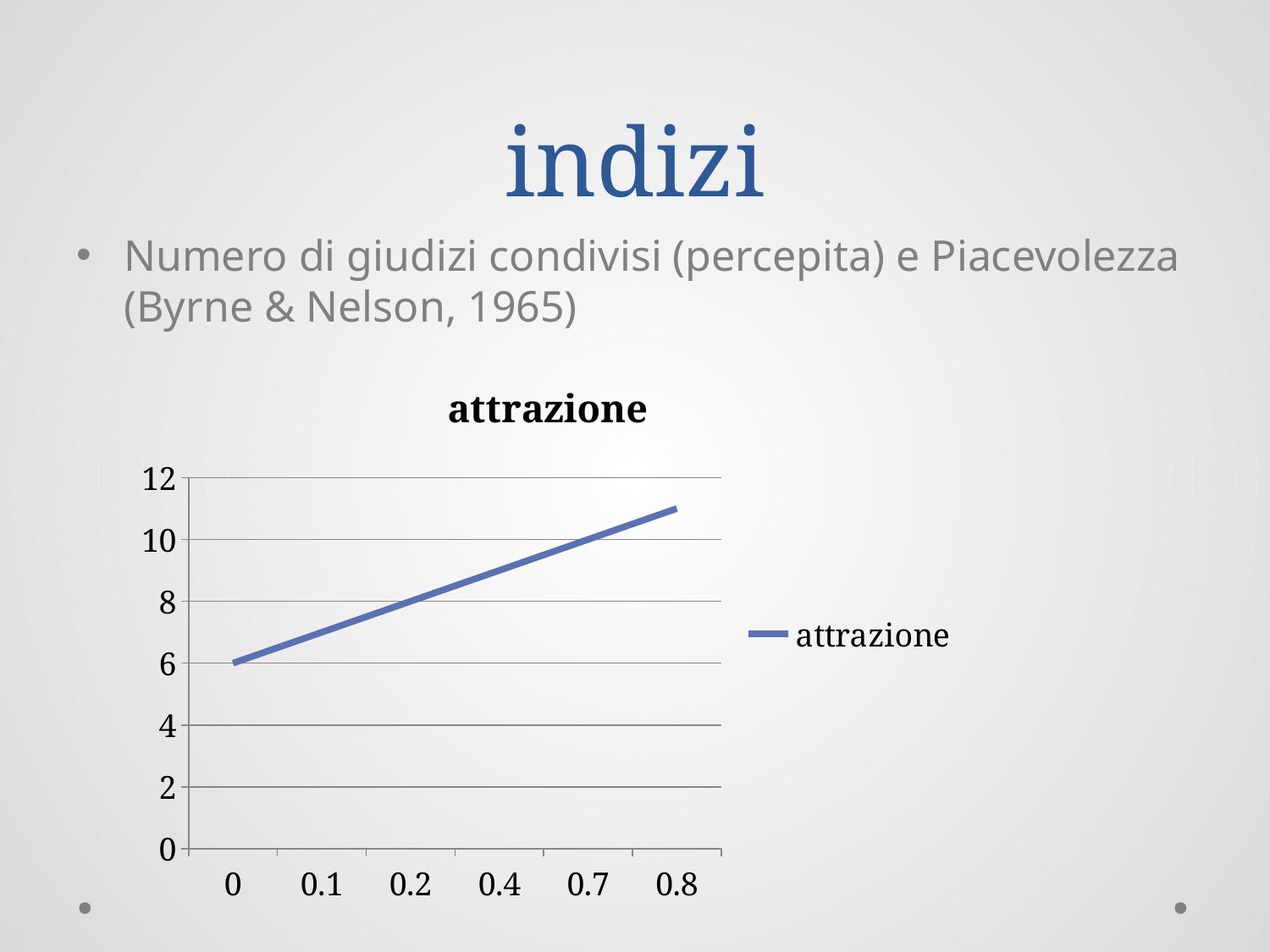
How many series does the legend list? 1 Do the values rise or fall along the x axis? rise What is the title of the chart? attrazione At which x value is attrazione highest? 0.8 Is the value of attrazione at x = 0.8 greater or less than 10? greater Is the value of attrazione at x = 0.1 greater or less than 8? less At which x value is attrazione lowest? 0 Which has the larger attrazione value, x = 0.7 or x = 0.2? 0.7 What is the name of the series shown in the legend? attrazione What kind of chart is shown on the slide? line chart How many categories are shown on the x axis? 6 What is the value of attrazione at x = 0? 6